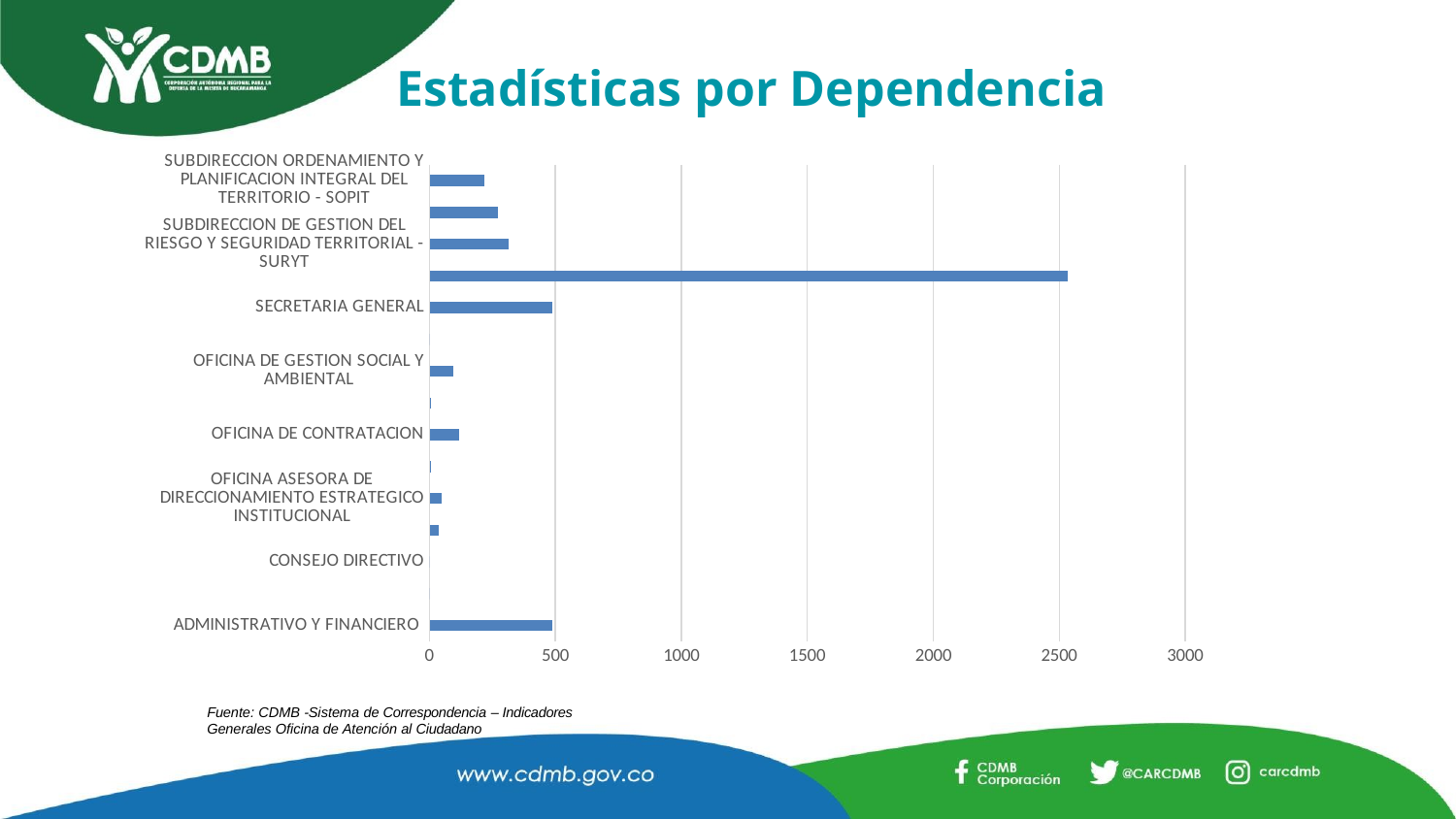
What is the highest value shown on the horizontal axis of the chart? 3000 How many category labels are shown on the vertical axis of the chart? 8 What is the title of the chart on the slide? Estadísticas por Dependencia Is the value for SECRETARIA GENERAL greater or less than 1000? less Is the value for OFICINA DE GESTION SOCIAL Y AMBIENTAL greater or less than 500? less What type of chart is shown on the slide? bar chart Is the value for OFICINA DE CONTRATACION greater or less than 500? less Which is larger, the value for ADMINISTRATIVO Y FINANCIERO or the value for OFICINA DE GESTION SOCIAL Y AMBIENTAL? ADMINISTRATIVO Y FINANCIERO Which is larger, the value for OFICINA DE CONTRATACION or the value for SECRETARIA GENERAL? SECRETARIA GENERAL